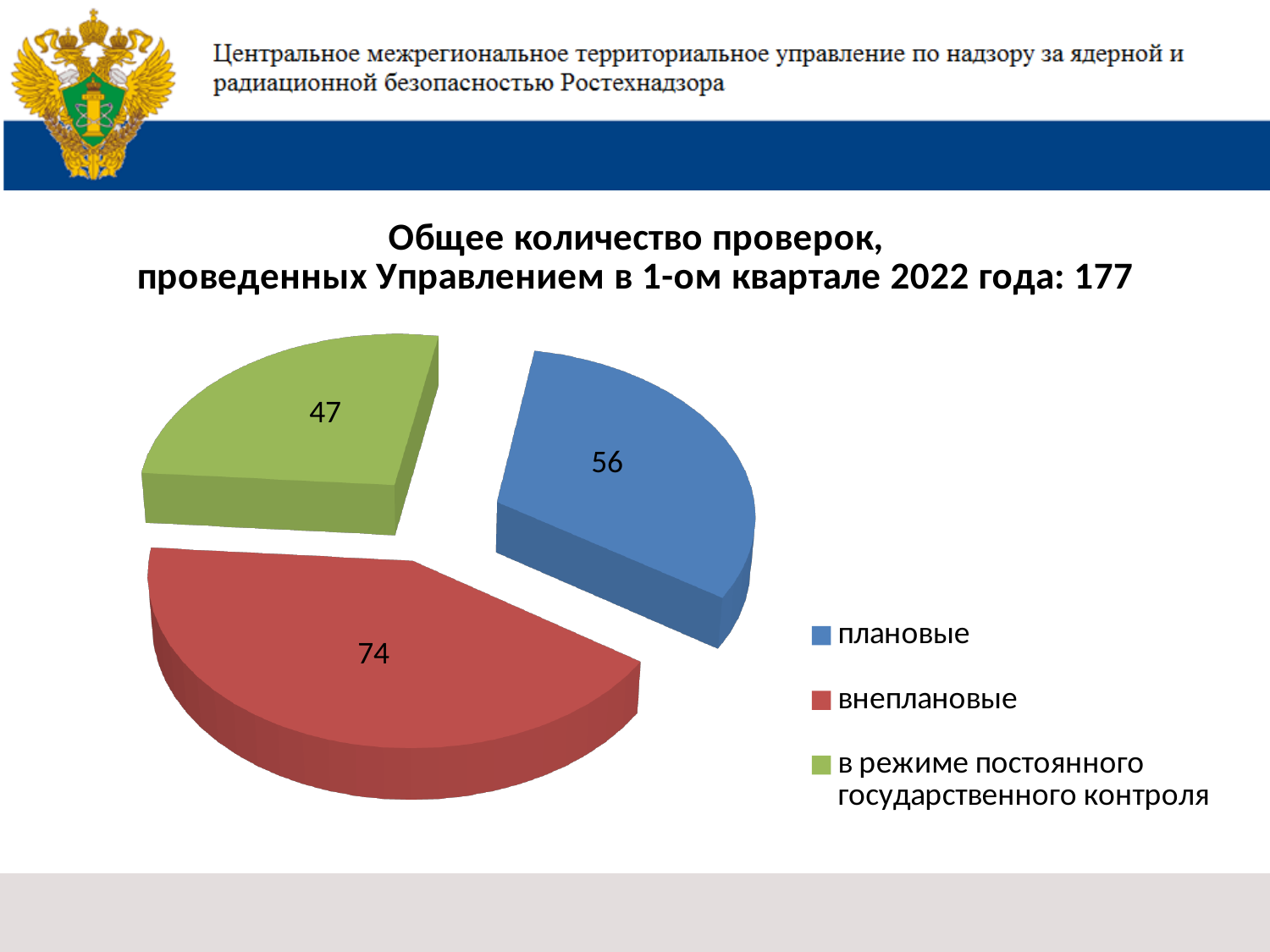
What type of chart is shown on the slide? pie chart What is the value for внеплановые (unplanned) inspections? 74 By how much does the плановые value exceed the value for 'в режиме постоянного государственного контроля'? 9 How many inspections were плановые (planned)? 56 Which category has the smallest slice of the pie? в режиме постоянного государственного контроля How many slices does the pie chart have? 3 What colour is the slice for внеплановые inspections? red What is the difference between the внеплановые and плановые values? 18 Which is larger: плановые or внеплановые? внеплановые Which category has the largest slice of the pie? внеплановые What is the total number of inspections shown in the chart title? 177 What is the value for the slice 'в режиме постоянного государственного контроля'? 47